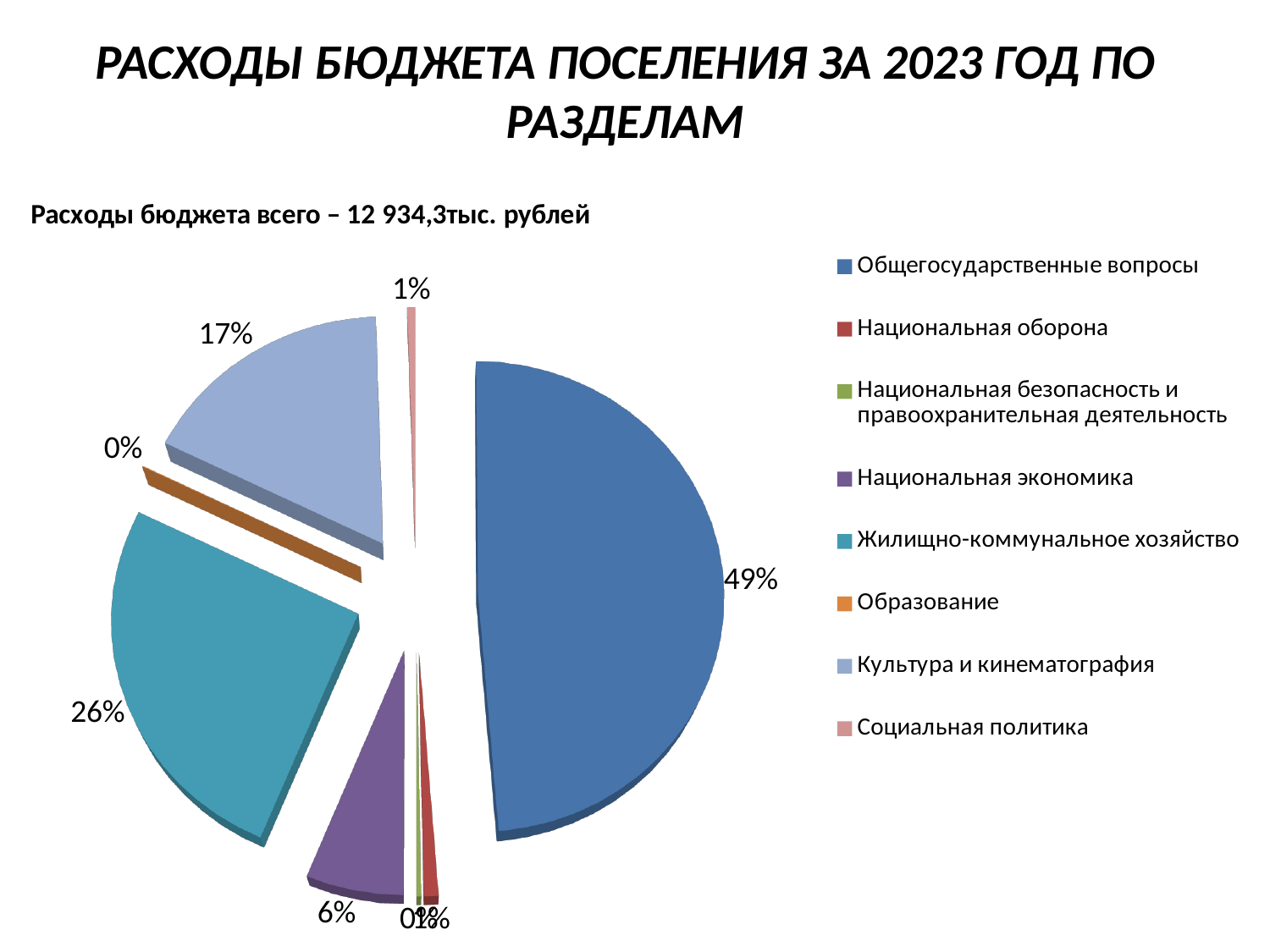
Which category has the largest share of the pie? Общегосударственные вопросы What kind of chart is shown on the slide? pie chart What share of the pie does "Социальная политика" take? 1% What total budget expenditure is stated above the chart? 12 934,3 тыс. рублей What share of the pie does "Культура и кинематография" take? 17% What share of the pie does "Образование" take? 0% By how many percentage points does the share of "Общегосударственные вопросы" exceed that of "Жилищно-коммунальное хозяйство"? 23 percentage points How many categories does the legend of the pie chart list? 8 Which has the larger share: "Жилищно-коммунальное хозяйство" or "Культура и кинематография"? Жилищно-коммунальное хозяйство